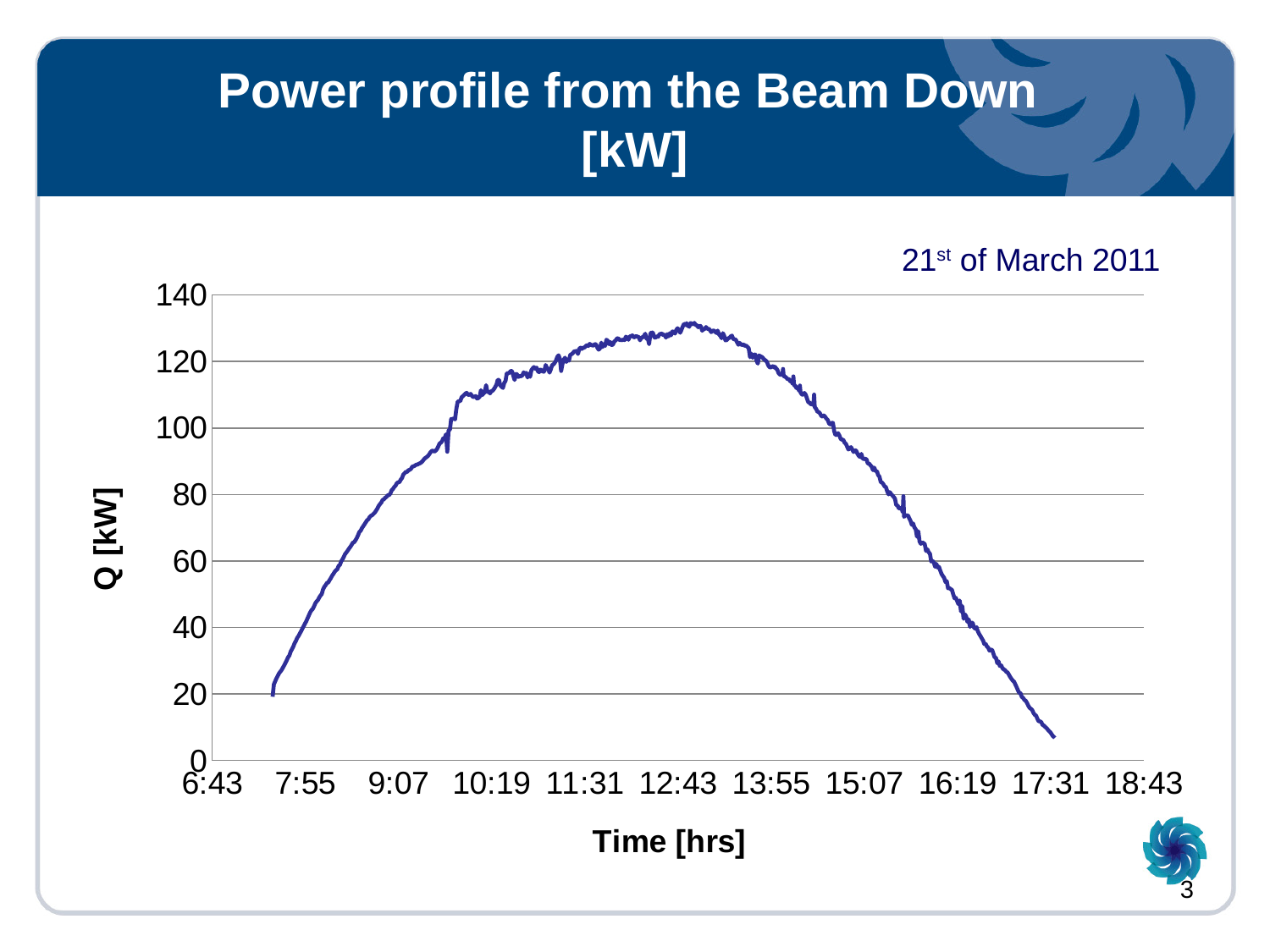
What is the title of the chart on the slide? Power profile from the Beam Down [kW] What is the label of the y axis? Q [kW] Around which x-axis tick does the line reach its highest value? 12:43 Is the value at 9:07 greater or less than 60? greater What kind of chart is shown on the slide? line chart Does the line rise or fall between 12:43 and 17:31? fall Is the value at 10:19 greater or less than 100? greater Does the line rise or fall between 7:55 and 12:43? rise Is the value at 17:31 greater or less than 20? less